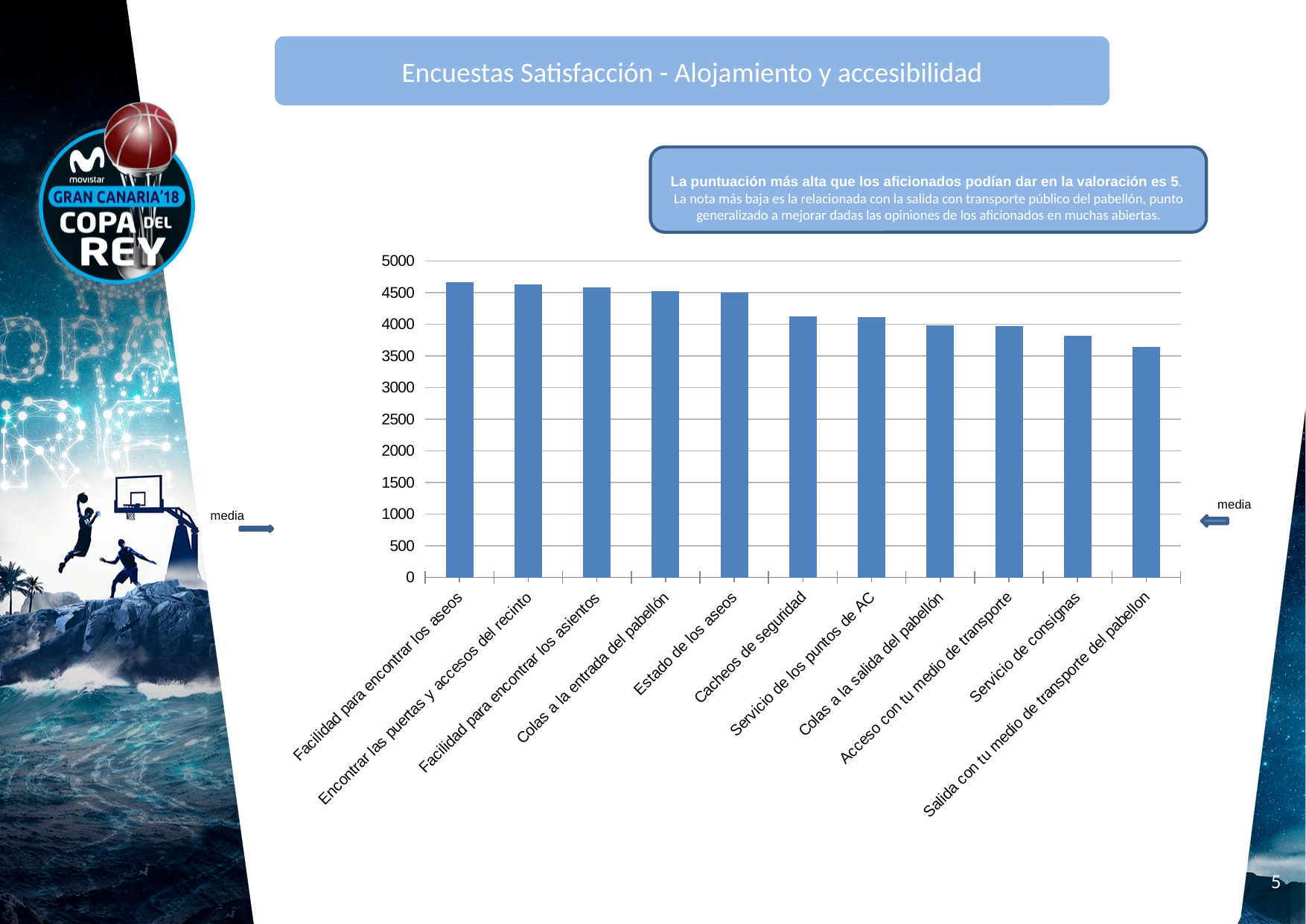
Is the value for Facilidad para encontrar los aseos greater or less than 4500? greater How many categories are plotted on the chart? 11 Which category has the lowest value on the chart? Salida con tu medio de transporte del pabellon Is the value for Servicio de consignas greater or less than 4000? less Do the bar values rise or fall from left to right along the x axis? fall Which is larger, the value for Facilidad para encontrar los aseos or the value for Salida con tu medio de transporte del pabellon? Facilidad para encontrar los aseos What kind of chart is shown on the slide? bar chart Is the value for Encontrar las puertas y accesos del recinto greater or less than 4500? greater What is the highest value shown on the chart's vertical axis? 5000 Which is larger, the value for Cacheos de seguridad or the value for Servicio de consignas? Cacheos de seguridad